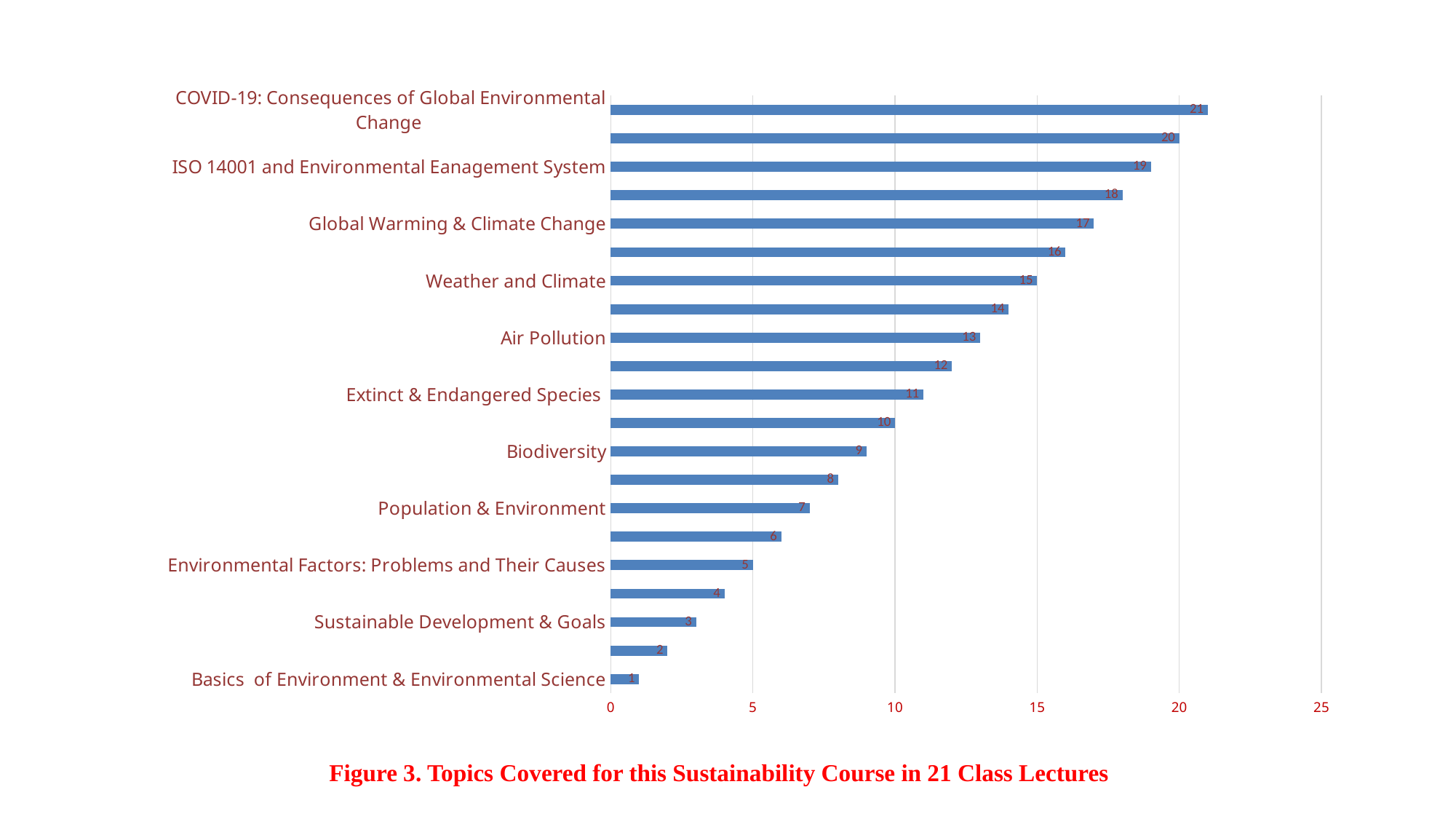
What is the value for COVID-19: Consequences of Global Environmental Change? 21 Which labelled topic has the highest value? COVID-19: Consequences of Global Environmental Change What is the caption of the figure shown on the slide? Figure 3. Topics Covered for this Sustainability Course in 21 Class Lectures What is the value for Biodiversity? 9 Which has a larger value, Extinct & Endangered Species or Population & Environment? Extinct & Endangered Species What kind of chart is shown on the slide? bar chart What is the value for Basics of Environment & Environmental Science? 1 How many bars are plotted in the chart? 21 What is the difference between the values for ISO 14001 and Environmental Eanagement System and Weather and Climate? 4 What is the value for Air Pollution? 13 What is the value for Global Warming & Climate Change? 17 Which labelled topic has the lowest value? Basics of Environment & Environmental Science